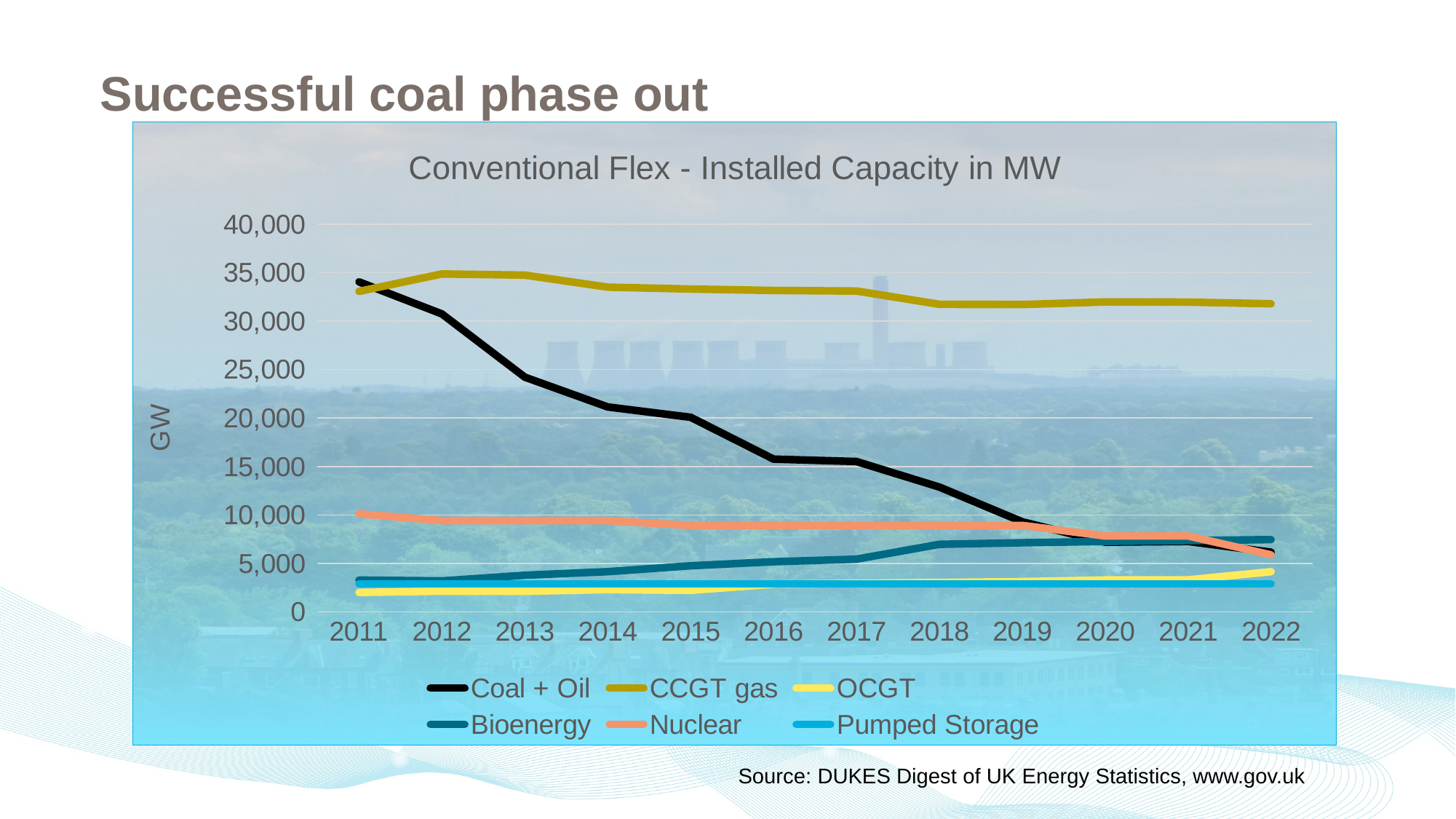
Is the value for Coal + Oil in 2022 greater or less than 10,000? less How many series does the legend list? 6 Does the Coal + Oil series rise or fall from 2011 to 2022? Fall Is the value for CCGT gas in 2022 greater or less than 30,000? greater Does the Bioenergy series rise or fall from 2011 to 2022? Rise Is the value for Coal + Oil in 2011 greater or less than 30,000? greater Which series has the lowest value in 2011? OCGT Which series has the highest value in 2022? CCGT gas What type of chart is shown on the slide? Line chart How many years are plotted along the x axis? 12 What is the title of the chart? Conventional Flex - Installed Capacity in MW In 2011, which is larger: Nuclear or Bioenergy? Nuclear